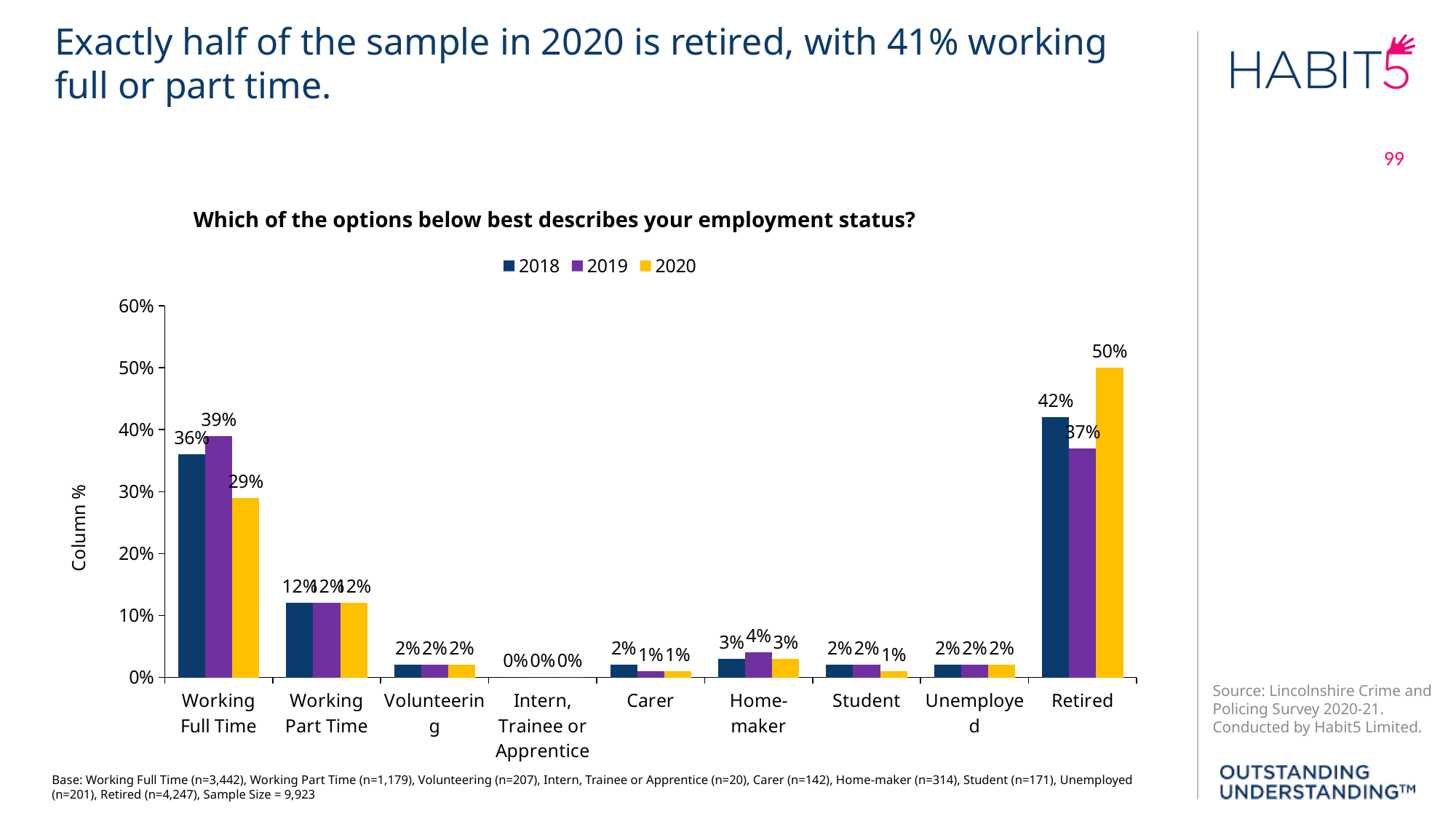
What is the value for Home-maker in 2019? 4% How many series does the legend list? 3 What is the difference between the 2020 and 2019 values for Retired? 13% What is the label on the y axis of the chart? Column % Does the value for Working Full Time rise or fall from 2018 to 2020? Fall What percentage of the 2020 sample is Retired? 50% What is the value for Working Full Time in 2018? 36% Which category has the lowest value across all three years? Intern, Trainee or Apprentice Which is larger for Working Full Time: the 2019 value or the 2020 value? 2019 What kind of chart is shown on the slide? Bar chart How many employment status categories are shown on the x axis? 9 Which category has the highest value for 2020? Retired